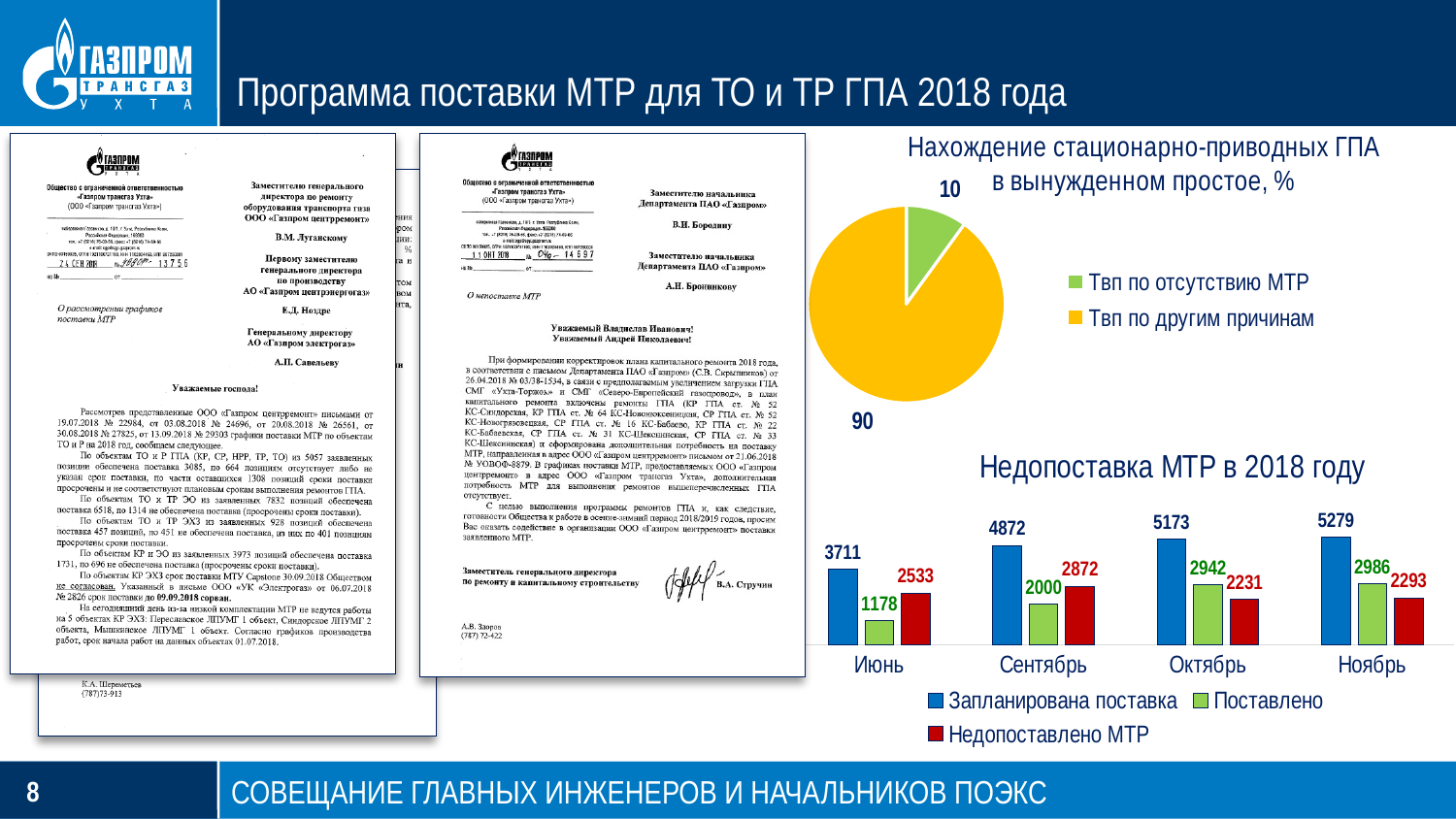
In the chart 'Недопоставка МТР в 2018 году', does the value of 'Запланирована поставка' rise or fall from Июнь to Ноябрь? rise In the chart 'Недопоставка МТР в 2018 году', which month has the lowest value of 'Поставлено'? Июнь In the pie chart 'Нахождение стационарно-приводных ГПА в вынужденном простое, %', how many slices are there? 2 In the chart 'Недопоставка МТР в 2018 году', what is the value of 'Запланирована поставка' for Октябрь? 5173 In the chart 'Недопоставка МТР в 2018 году', what is the value of 'Недопоставлено МТР' for Сентябрь? 2872 In the chart 'Недопоставка МТР в 2018 году', which month has the highest value of 'Запланирована поставка'? Ноябрь In the chart 'Недопоставка МТР в 2018 году', is 'Недопоставлено МТР' larger for Сентябрь or for Октябрь? Сентябрь In the pie chart 'Нахождение стационарно-приводных ГПА в вынужденном простое, %', which slice is the largest? Твп по другим причинам In the chart 'Недопоставка МТР в 2018 году', what is the difference between 'Запланирована поставка' and 'Поставлено' for Ноябрь? 2293 In the pie chart 'Нахождение стационарно-приводных ГПА в вынужденном простое, %', what is the value for 'Твп по отсутствию МТР'? 10 In the chart 'Недопоставка МТР в 2018 году', what is the value of 'Поставлено' for Июнь? 1178 In the chart 'Недопоставка МТР в 2018 году', how many series does the legend list? 3